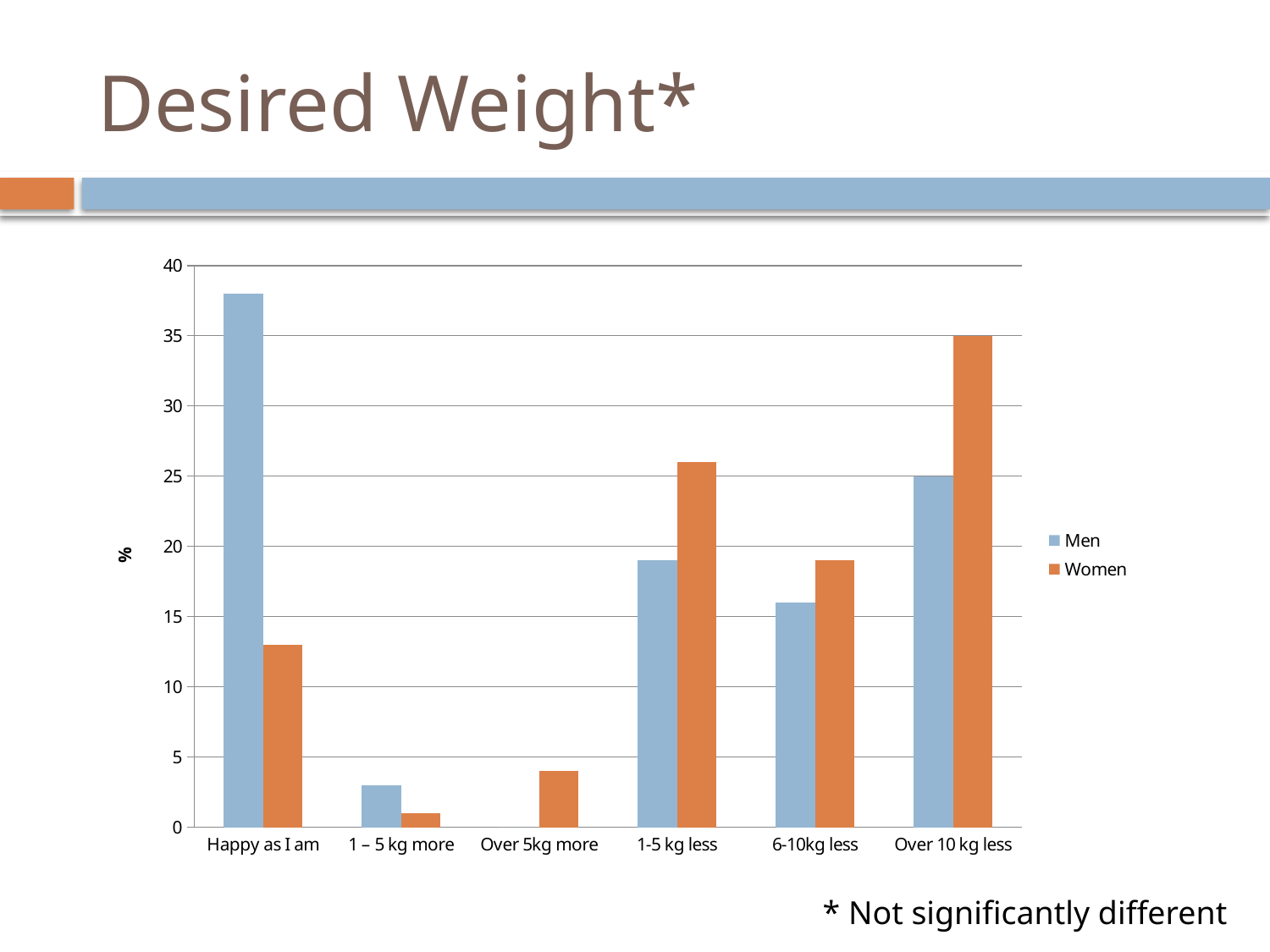
How many categories are shown on the x axis? 6 What is the value for Women in the 'Over 10 kg less' category? 35 Which category has the highest value for Men? Happy as I am What is the label on the vertical axis? % Which category has the lowest value for Women? 1 – 5 kg more Which category has the highest value for Women? Over 10 kg less How many series does the legend list? 2 In the 'Happy as I am' category, which is larger, Men or Women? Men What kind of chart is shown on the slide? bar chart Is the value for Men in the 'Happy as I am' category greater or less than 35? greater Is the value for Women in the '1-5 kg less' category greater or less than 25? greater What is the value for Men in the 'Over 10 kg less' category? 25